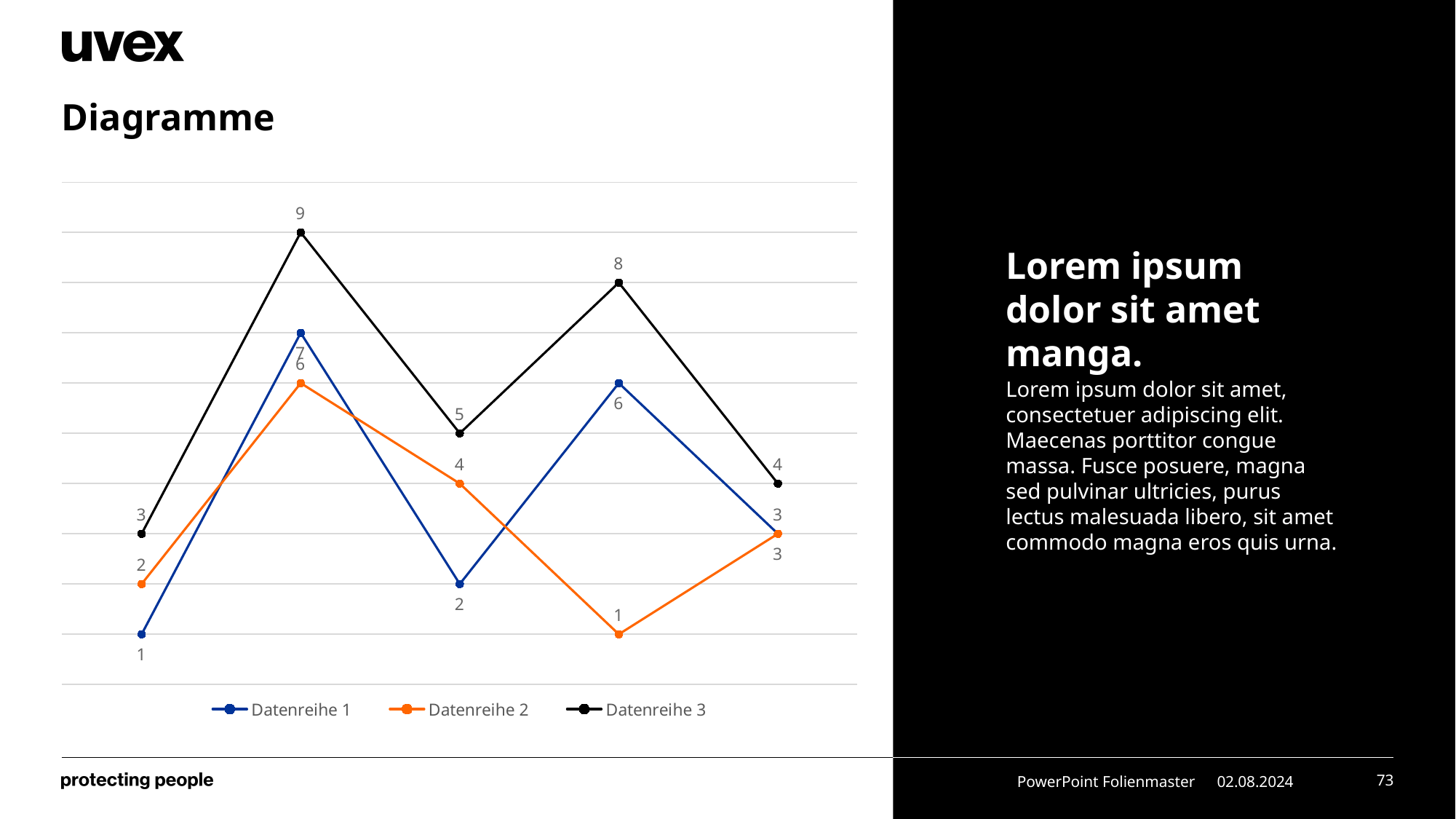
What kind of chart is shown on the slide? line chart How many series does the legend list? 3 What is the value of Datenreihe 2 at its fourth point? 1 At the fourth point, which series has the larger value, Datenreihe 1 or Datenreihe 2? Datenreihe 1 What is the value of Datenreihe 3 at its second point? 9 What is the highest value plotted for Datenreihe 1? 7 What is the value of Datenreihe 1 at its first point? 1 Does Datenreihe 2 rise or fall from its second point to its fourth point? fall What is the lowest value plotted for Datenreihe 3? 3 What is the difference between Datenreihe 3 and Datenreihe 1 at the second point? 2 Which series is drawn in orange? Datenreihe 2 How many data points does each series have? 5